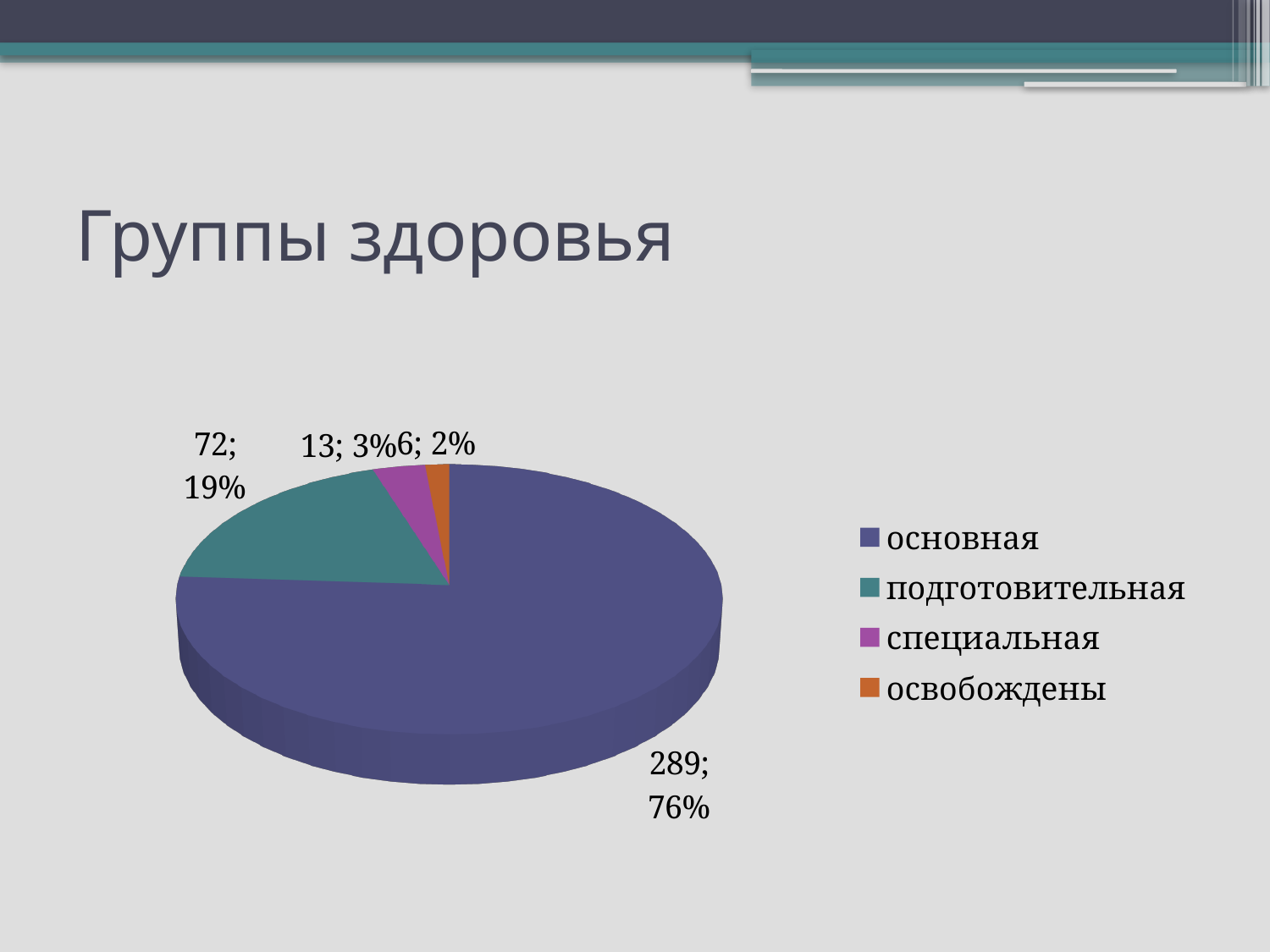
How many categories does the pie chart have? 4 What share of the pie does основная take? 76% What is the value for освобождены? 6 What is the value for специальная? 13 What is the title of the slide? Группы здоровья Which category has the largest slice? основная What is the value for подготовительная? 72 What share of the pie does подготовительная take? 19% What is the difference between the values for основная and подготовительная? 217 Which category has the smallest slice? освобождены What kind of chart is shown on the slide? pie chart What is the value for основная? 289